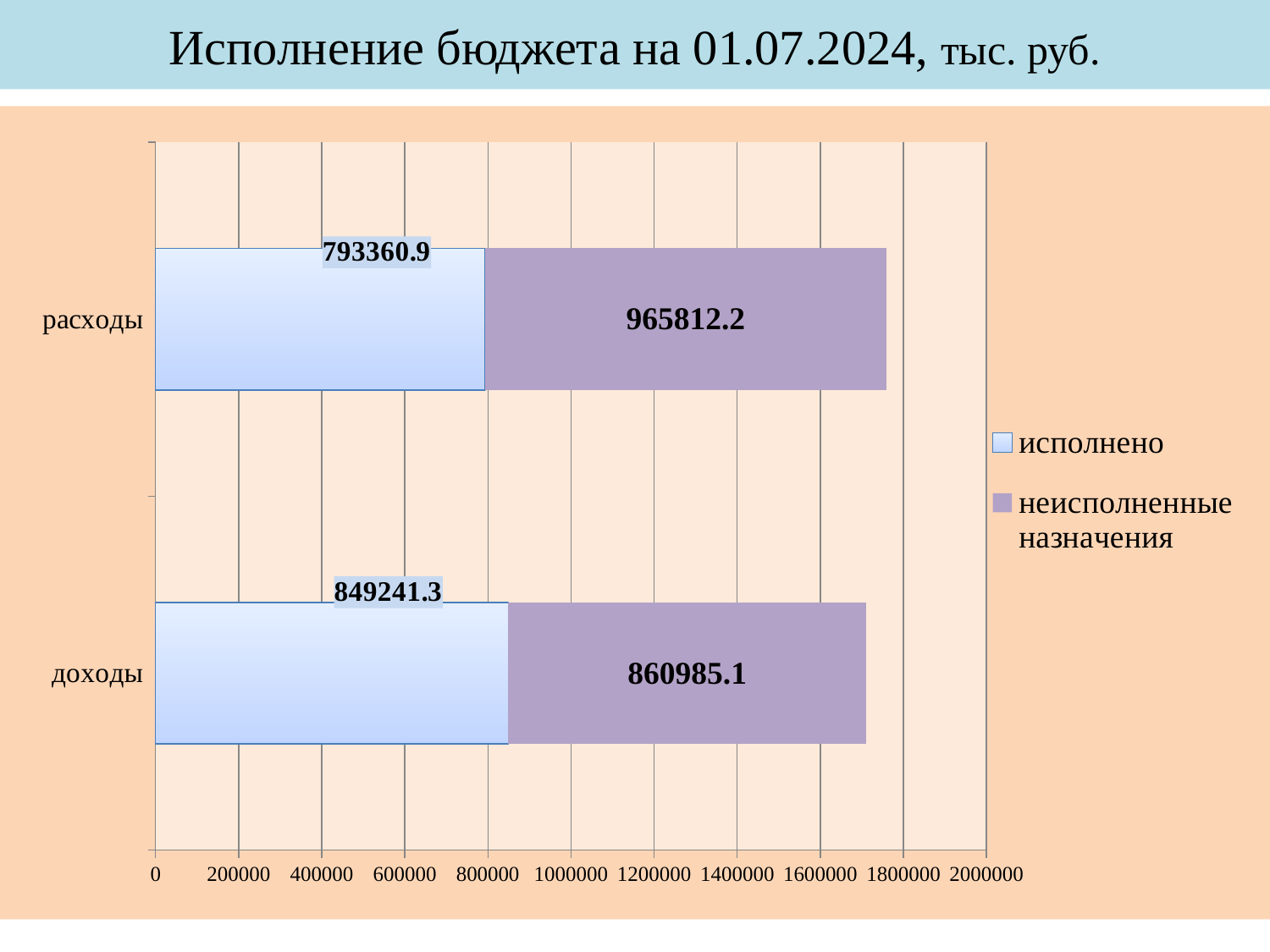
What is the value of исполнено for доходы? 849241.3 What type of chart is shown on the slide? stacked bar chart What is the value of неисполненные назначения for расходы? 965812.2 What is the total of the stacked bar for расходы? 1759173.1 What is the title of the chart? Исполнение бюджета на 01.07.2024, тыс. руб. How many series does the legend list? 2 What is the total of the stacked bar for доходы? 1710226.4 Which category has the higher value for неисполненные назначения, расходы or доходы? расходы What is the value of неисполненные назначения for доходы? 860985.1 How many categories are shown on the chart? 2 What is the difference between the исполнено values for доходы and расходы? 55880.4 What is the value of исполнено for расходы? 793360.9